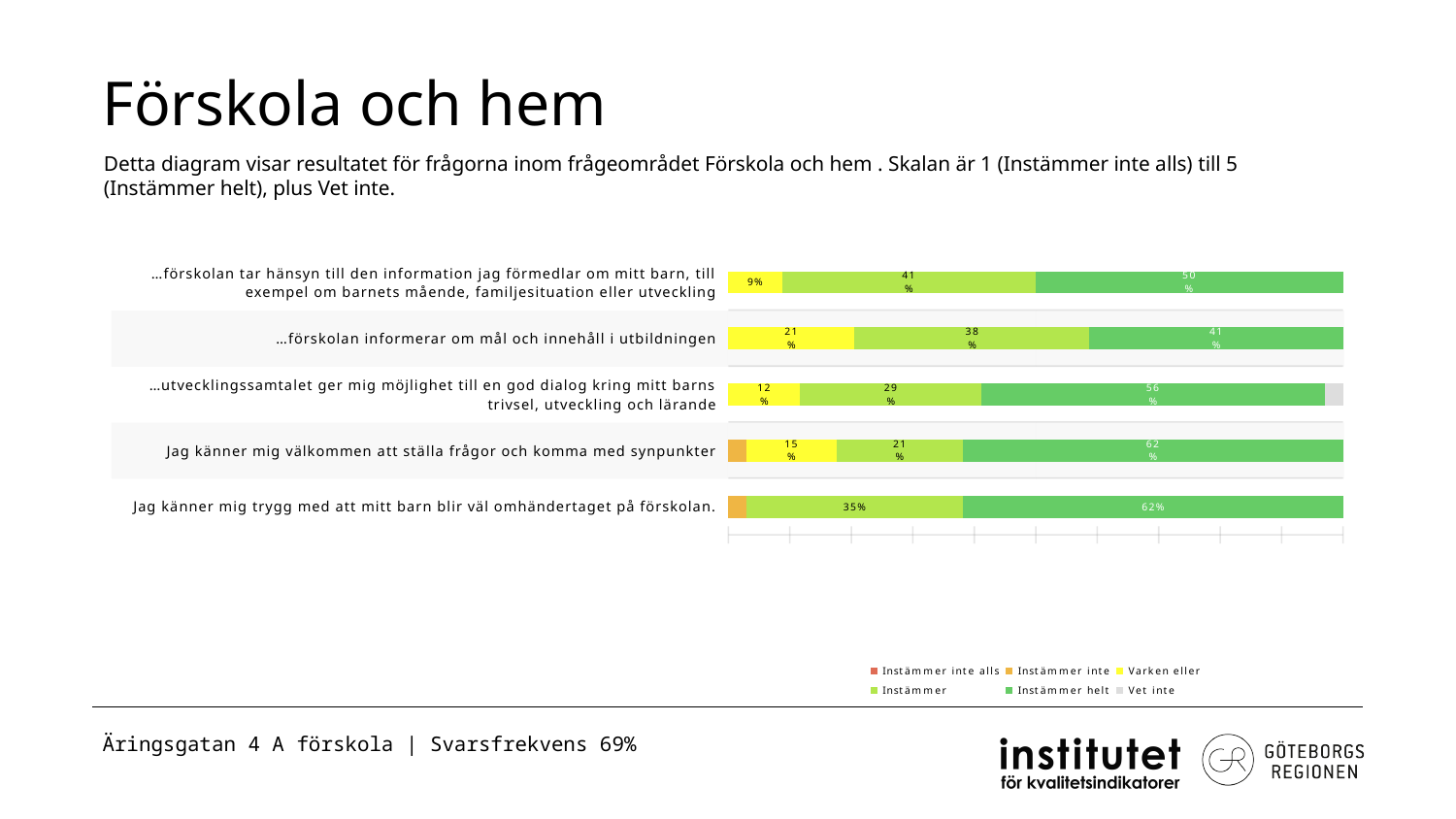
What is the 'Varken eller' value for '…förskolan tar hänsyn till den information jag förmedlar om mitt barn, till exempel om barnets mående, familjesituation eller utveckling'? 9% What is the title of the slide containing the chart? Förskola och hem What is the 'Instämmer helt' value for '…utvecklingssamtalet ger mig möjlighet till en god dialog kring mitt barns trivsel, utveckling och lärande'? 56% Which is larger: the 'Instämmer' value for 'Jag känner mig trygg med att mitt barn blir väl omhändertaget på förskolan.' or for 'Jag känner mig välkommen att ställa frågor och komma med synpunkter'? Jag känner mig trygg med att mitt barn blir väl omhändertaget på förskolan. What kind of chart is shown on the slide? bar chart Which statement has the highest 'Varken eller' value? …förskolan informerar om mål och innehåll i utbildningen How many categories (statements) are plotted in the chart? 5 What is the 'Instämmer' value for '…förskolan informerar om mål och innehåll i utbildningen'? 38% What is the difference in 'Instämmer helt' between '…förskolan tar hänsyn till den information jag förmedlar om mitt barn…' and '…förskolan informerar om mål och innehåll i utbildningen'? 9 percentage points How many series does the legend list? 6 What is the 'Instämmer helt' value for 'Jag känner mig trygg med att mitt barn blir väl omhändertaget på förskolan.'? 62% Which statement has the lowest 'Instämmer helt' value? …förskolan informerar om mål och innehåll i utbildningen